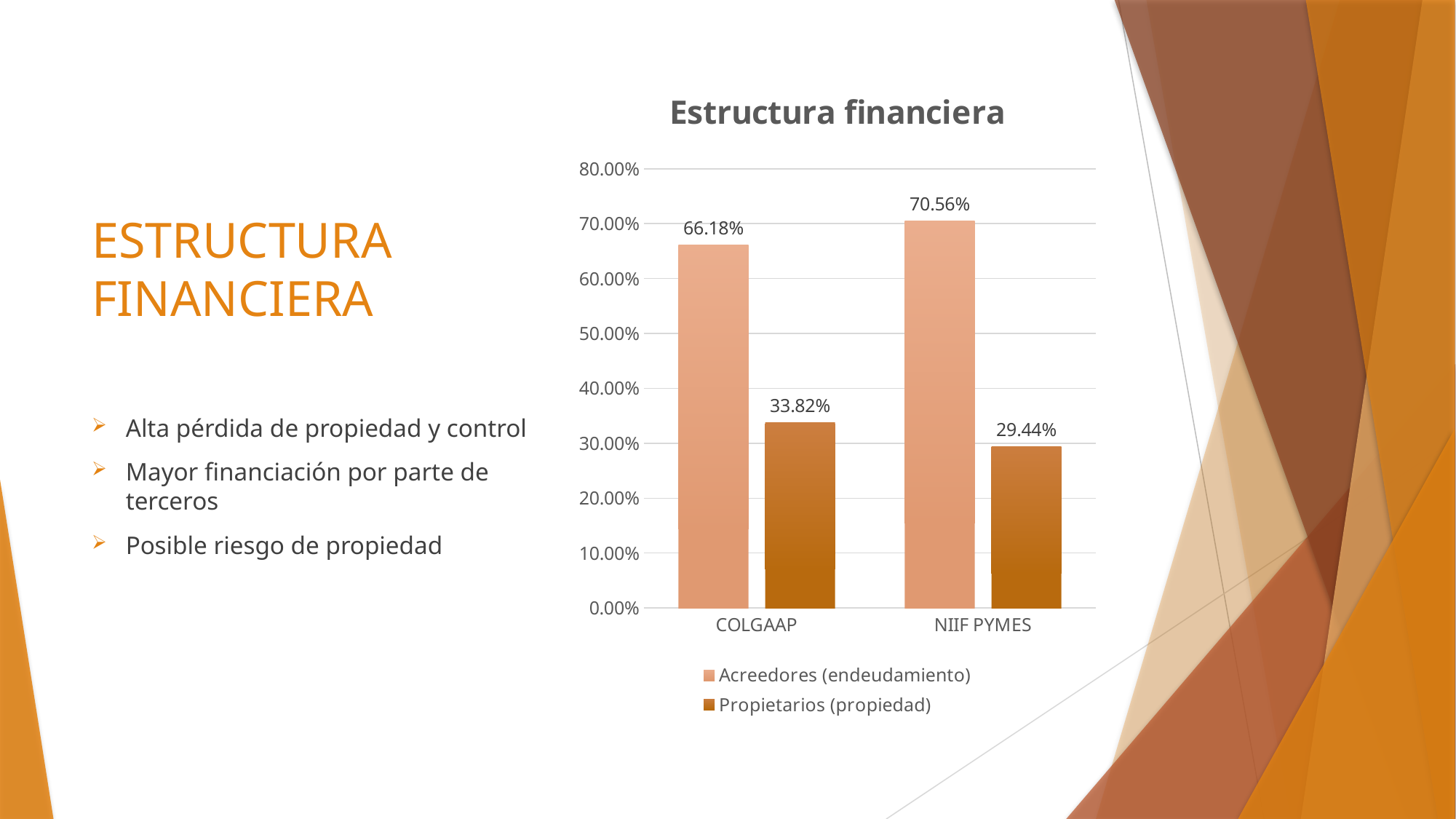
What is the value for Propietarios (propiedad) under NIIF PYMES? 29.44% How many categories are shown on the x axis? 2 Which category has the lowest value for Propietarios (propiedad)? NIIF PYMES What is the value for Propietarios (propiedad) under COLGAAP? 33.82% How many series does the legend list? 2 Which is larger: Propietarios (propiedad) for COLGAAP or for NIIF PYMES? COLGAAP What is the difference between the Acreedores (endeudamiento) values for NIIF PYMES and COLGAAP? 4.38% What type of chart is shown on the slide? Bar chart Is the value for Acreedores (endeudamiento) under NIIF PYMES greater or less than 70.00%? greater What is the value for Acreedores (endeudamiento) under COLGAAP? 66.18% What is the value for Acreedores (endeudamiento) under NIIF PYMES? 70.56% Which category has the highest value for Acreedores (endeudamiento)? NIIF PYMES